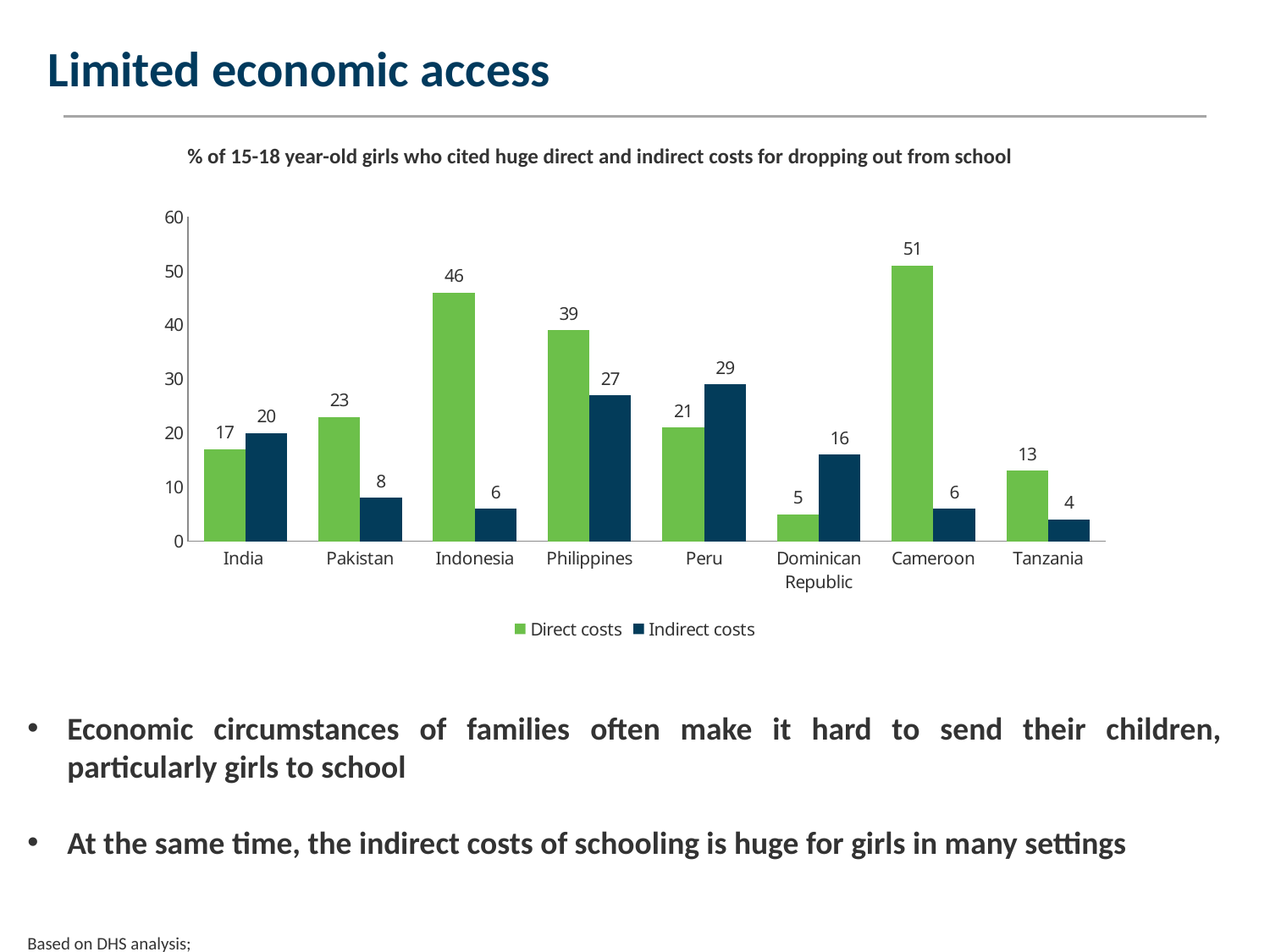
What is the Direct costs value for Indonesia? 46 Which country has the highest Direct costs value? Cameroon What is the Indirect costs value for Peru? 29 Is the Direct costs value for Cameroon greater or less than 40? greater What kind of chart is shown on the slide? Bar chart How many countries are shown on the x axis? 8 What is the Indirect costs value for Tanzania? 4 What is the difference between the Direct costs and Indirect costs values for Indonesia? 40 How many series does the legend list? 2 Which is larger for the Dominican Republic, Direct costs or Indirect costs? Indirect costs Which country has the lowest Indirect costs value? Tanzania Which colour represents Indirect costs in the chart? Dark blue